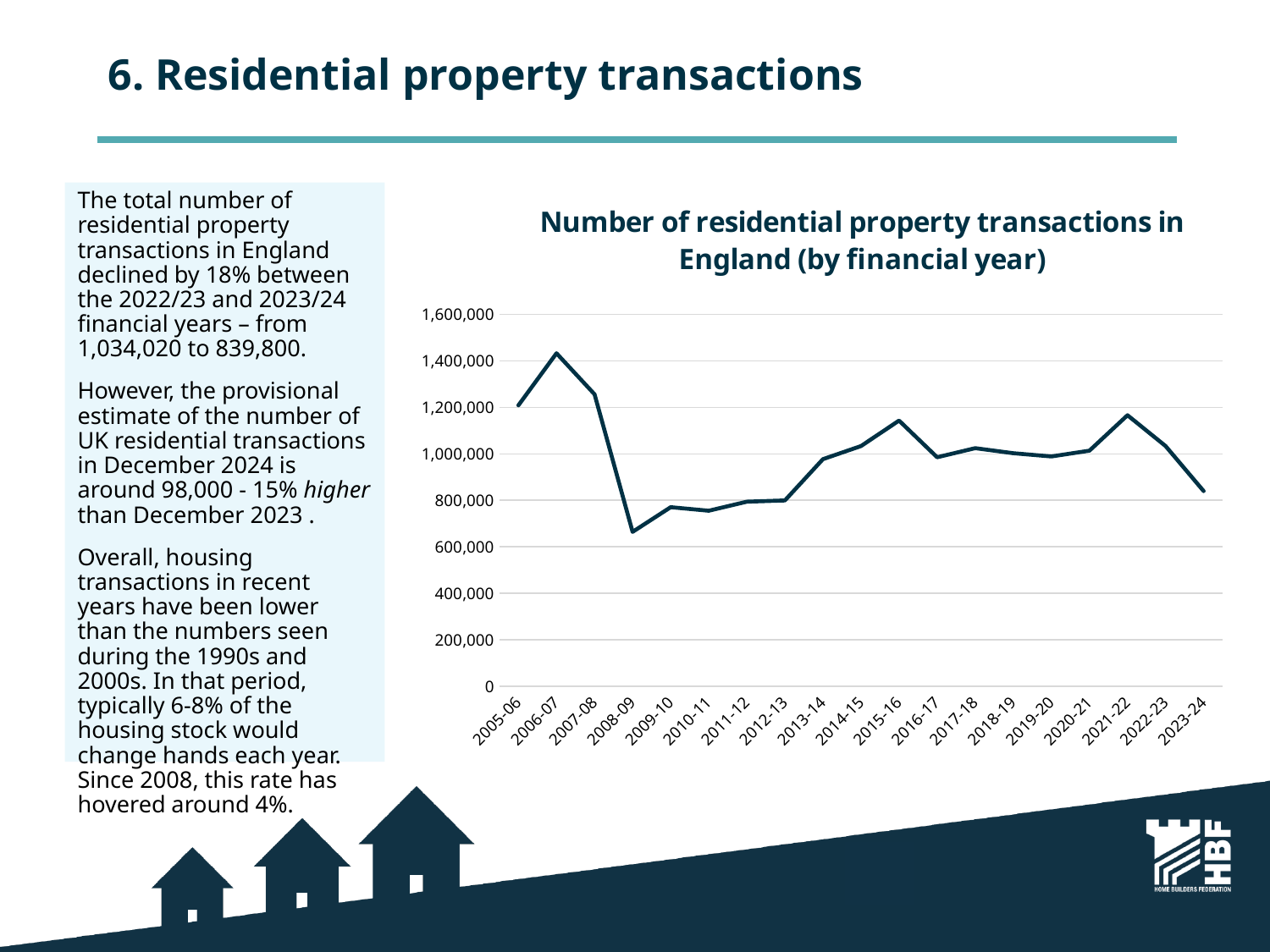
Which financial year has the highest number of residential property transactions? 2006-07 Which has more residential property transactions, 2021-22 or 2016-17? 2021-22 Which has more residential property transactions, 2006-07 or 2008-09? 2006-07 Is the value for 2023-24 greater or less than 1,000,000? less Which financial year has the lowest number of residential property transactions? 2008-09 Is the value for 2006-07 greater or less than 1,400,000? greater Is the value for 2021-22 greater or less than 1,000,000? greater What is the title of the chart? Number of residential property transactions in England (by financial year) What kind of chart is shown on the slide? line chart How many financial years are plotted on the x axis of the chart? 19 Do the values rise or fall from 2021-22 to 2023-24? fall